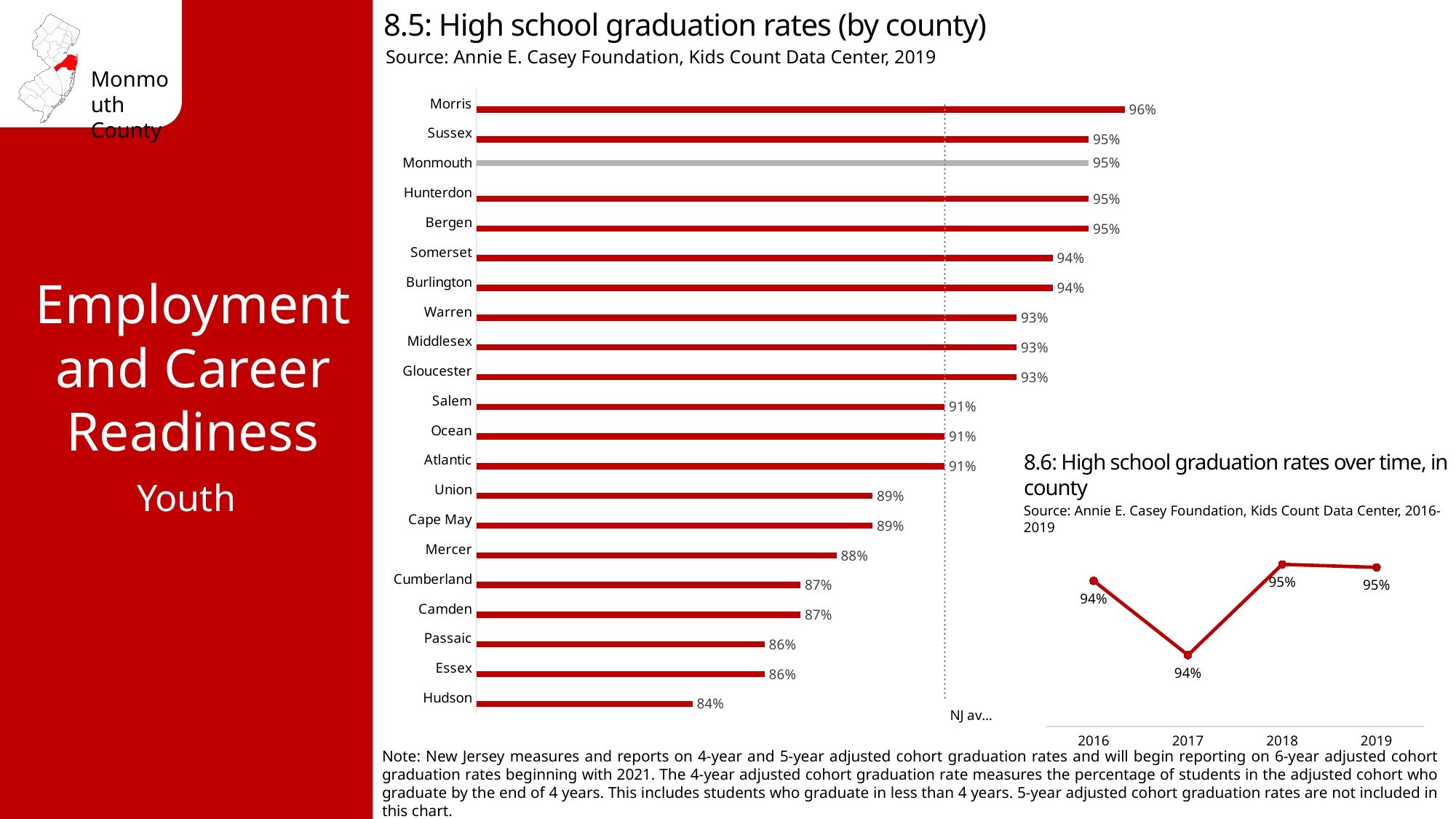
In chart 8.6 (High school graduation rates over time, in county), what is the graduation rate for 2017? 94% In chart 8.5 (High school graduation rates by county), which county's bar is shown in grey rather than red? Monmouth In chart 8.5 (High school graduation rates by county), what is the graduation rate for Monmouth? 95% In chart 8.5 (High school graduation rates by county), what is the difference between the graduation rates of Morris and Hudson? 12% In chart 8.5 (High school graduation rates by county), which county has the highest graduation rate? Morris In chart 8.5 (High school graduation rates by county), which county has the lowest graduation rate? Hudson In chart 8.5 (High school graduation rates by county), what is the graduation rate for Hudson? 84% In chart 8.6 (High school graduation rates over time, in county), how many years are plotted? 4 What kind of chart is chart 8.5 (High school graduation rates by county)? Bar chart In chart 8.5 (High school graduation rates by county), how many counties are shown? 21 In chart 8.5 (High school graduation rates by county), which has a higher graduation rate, Mercer or Somerset? Somerset What kind of chart is chart 8.6 (High school graduation rates over time, in county)? Line chart